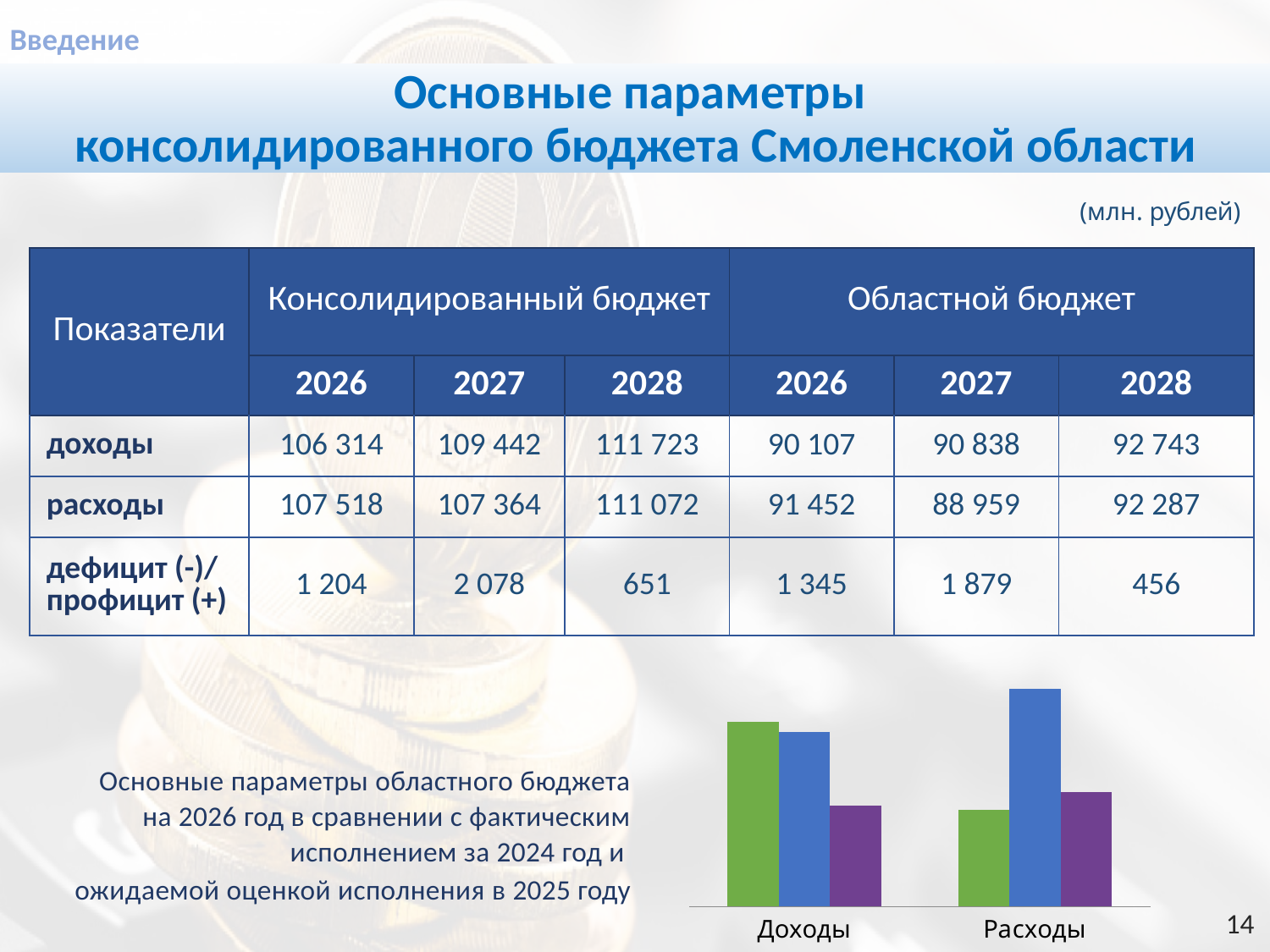
In the Доходы group of the bar chart, which coloured bar is the shortest? purple In the Доходы group of the bar chart, which coloured bar is the tallest? green In the bar chart, is the blue bar taller for Доходы or for Расходы? Расходы What are the two category labels on the x axis of the bar chart? Доходы and Расходы What kind of chart is shown at the bottom right of the slide? bar chart Does the bar chart display a legend? No In the bar chart, which category contains the tallest bar overall? Расходы How many categories are shown on the x axis of the bar chart? 2 How many bars are plotted in each category group of the bar chart? 3